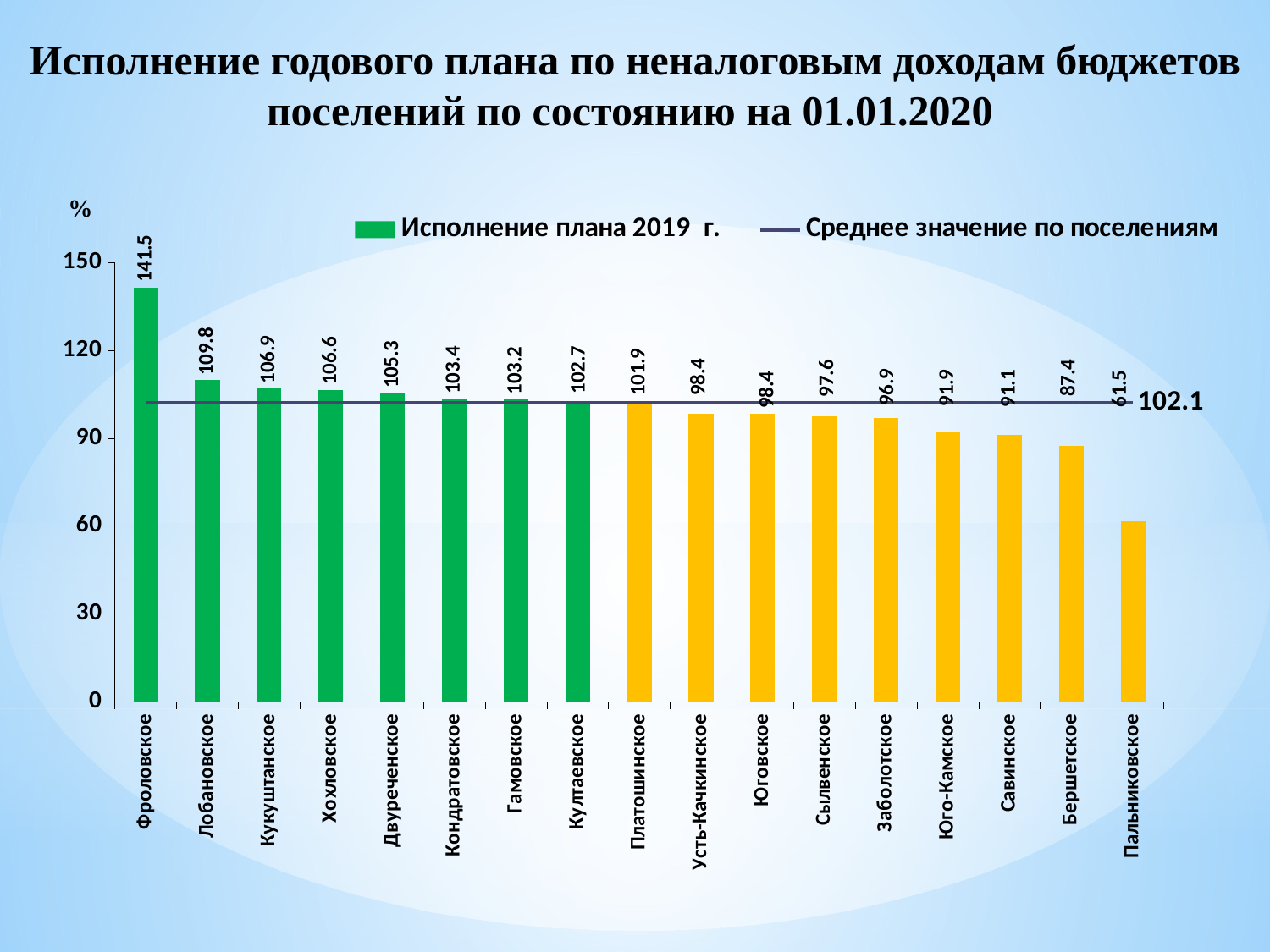
What is the value for Заболотское? 96.9 How many settlements are shown on the x axis? 17 How many entries does the legend list? 2 What is the difference between the values for Фроловское and Лобановское? 31.7 Which settlement has the lowest value? Пальниковское Is the value for Юго-Камское greater or less than 90? greater Which is larger, the value for Бершетское or the value for Савинское? Савинское What is the value of the average line (Среднее значение по поселениям)? 102.1 What is the value for Пальниковское? 61.5 Which settlement has the highest value? Фроловское What is the value for Фроловское? 141.5 What kind of chart is shown on the slide? bar chart